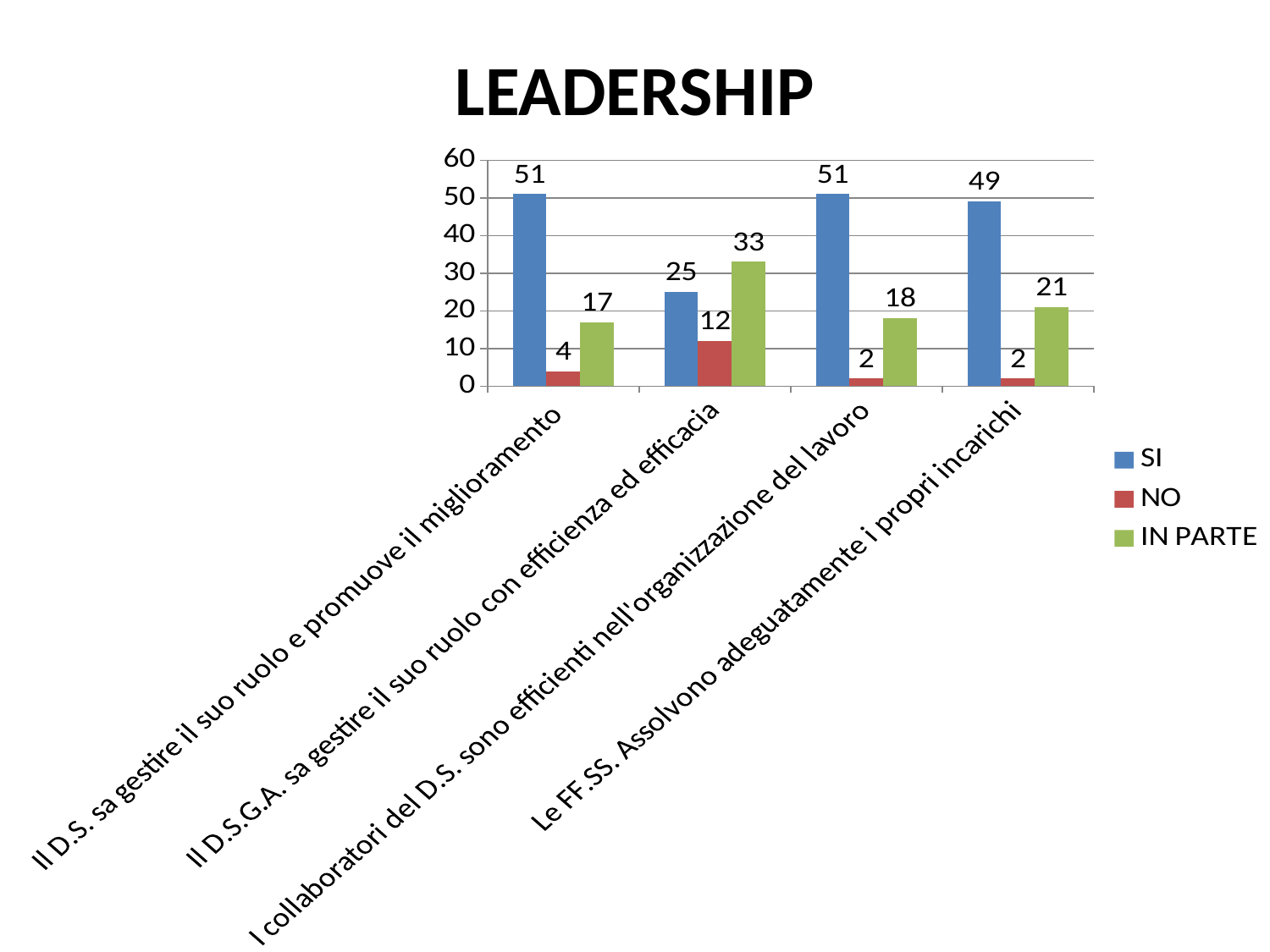
How many series does the legend list? 3 What is the NO value for "Il D.S. sa gestire il suo ruolo e promuove il miglioramento"? 4 What is the SI value for "Il D.S.G.A. sa gestire il suo ruolo con efficienza ed efficacia"? 25 How many categories are shown on the x axis? 4 What kind of chart is shown on the slide? Bar chart For "Il D.S.G.A. sa gestire il suo ruolo con efficienza ed efficacia", which is larger: SI or IN PARTE? IN PARTE What is the title of the slide? LEADERSHIP What is the IN PARTE value for "Le FF.SS. Assolvono adeguatamente i propri incarichi"? 21 Which category has the lowest SI value? Il D.S.G.A. sa gestire il suo ruolo con efficienza ed efficacia Which category has the highest IN PARTE value? Il D.S.G.A. sa gestire il suo ruolo con efficienza ed efficacia What is the difference between the SI and IN PARTE values for "I collaboratori del D.S. sono efficienti nell'organizzazione del lavoro"? 33 Which colour represents the NO series in the legend? Red